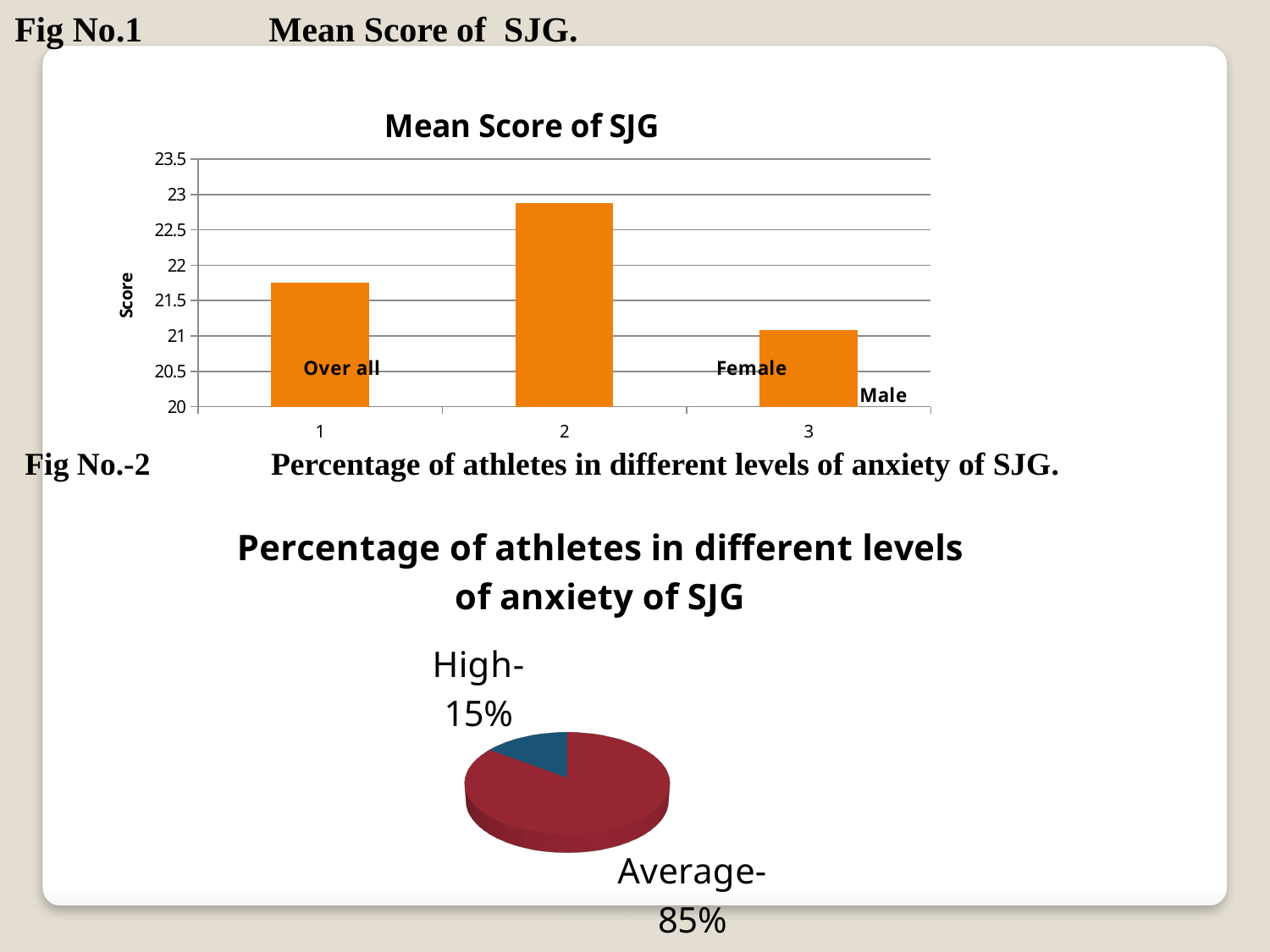
In the 'Percentage of athletes in different levels of anxiety of SJG' chart, what share of the pie is the Average level? 85% In the 'Percentage of athletes in different levels of anxiety of SJG' chart, what percentage of athletes have a High level of anxiety? 15% In the 'Mean Score of SJG' chart, what kind of chart is shown? bar chart In the 'Mean Score of SJG' chart, what is the label on the vertical axis? Score In the 'Mean Score of SJG' chart, is the value for Female greater or less than 22.5? greater In the 'Percentage of athletes in different levels of anxiety of SJG' chart, what kind of chart is shown? pie chart In the 'Mean Score of SJG' chart, which is larger, the mean score for Over all or for Male? Over all In the 'Mean Score of SJG' chart, which group has the highest mean score? Female In the 'Mean Score of SJG' chart, is the value for Over all greater or less than 21.5? greater In the 'Mean Score of SJG' chart, is the value for Male greater or less than 21.5? less In the 'Mean Score of SJG' chart, which group has the lowest mean score? Male In the 'Mean Score of SJG' chart, how many bars are plotted? 3